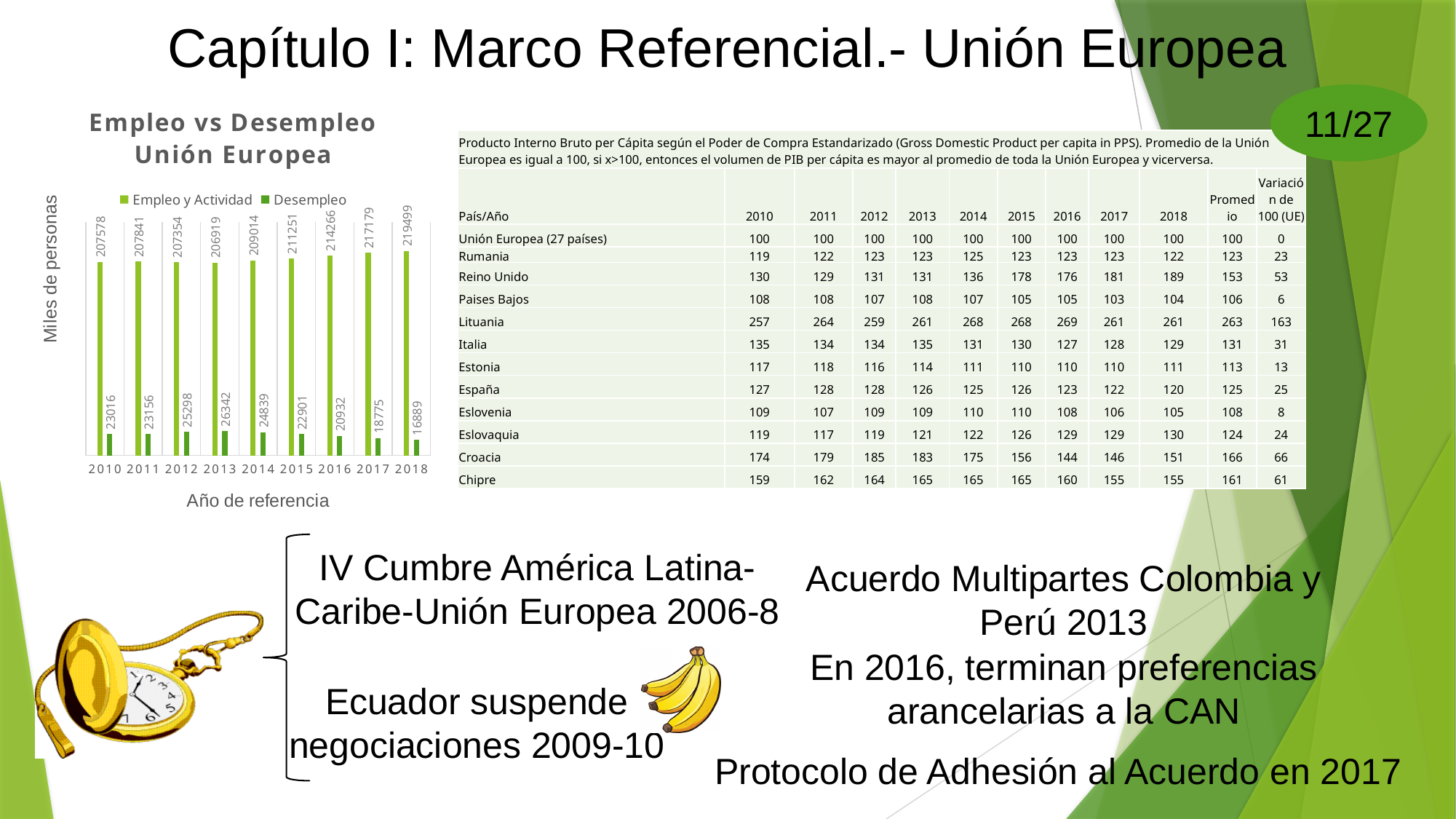
Which year has the lowest Desempleo value? 2018 What is the difference between the Desempleo values for 2010 and 2018? 6127 How many series does the legend list? 2 How many years are shown on the x axis? 9 Does the Desempleo value rise or fall from 2013 to 2018? fall What kind of chart is shown? bar chart Which year has the lowest Empleo y Actividad value? 2013 Which is larger, the Empleo y Actividad value for 2014 or for 2015? 2015 What is the value for Desempleo in 2013? 26342 What is the value for Empleo y Actividad in 2018? 219499 What is the value for Empleo y Actividad in 2010? 207578 Which year has the highest Desempleo value? 2013